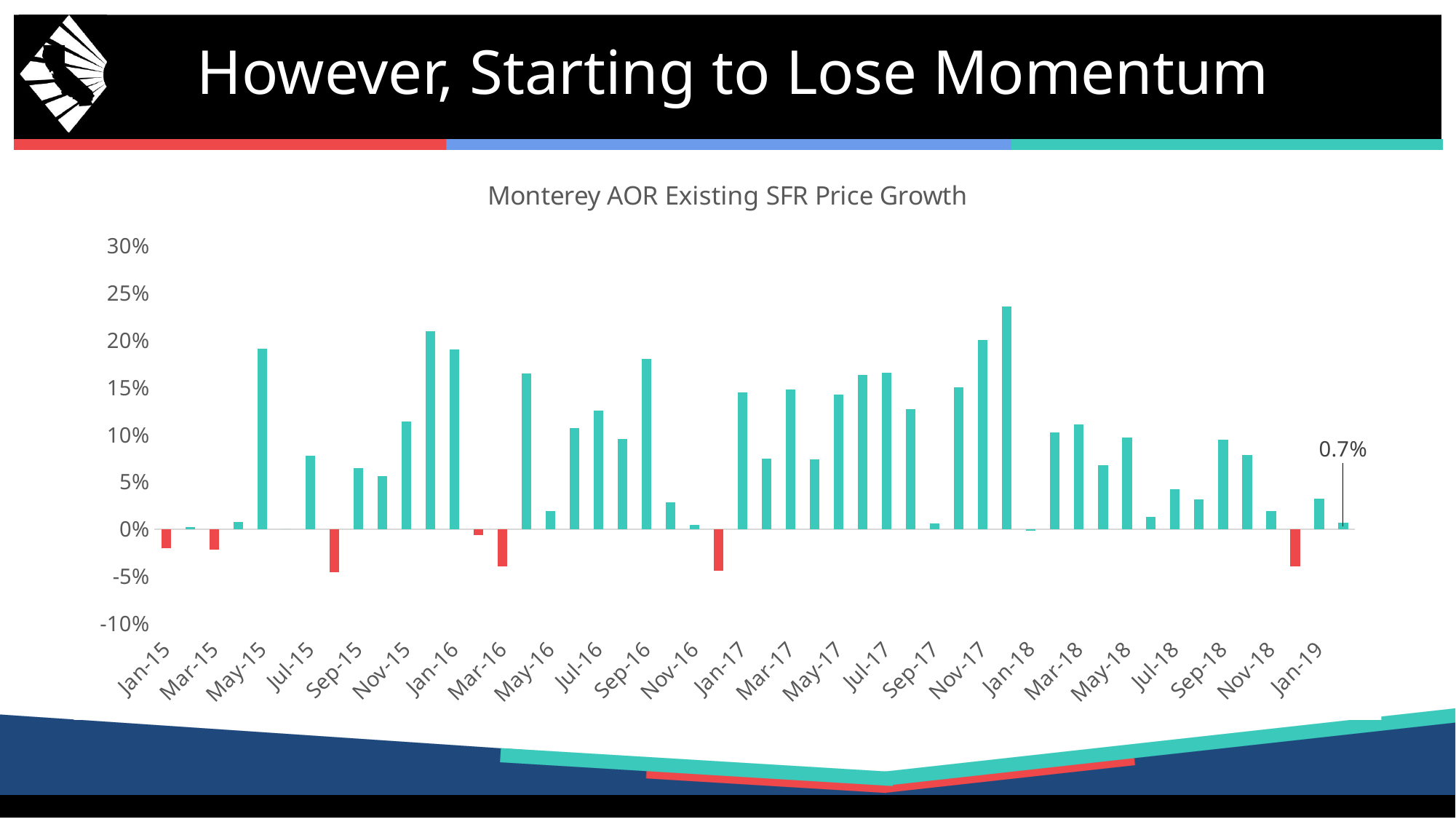
What value is shown by the data label on the last bar of the chart? 0.7% Do the values generally rise or fall from Nov-17 to Jan-19? fall What kind of chart is shown on the slide? bar chart What is the title of the chart? Monterey AOR Existing SFR Price Growth Which is larger, the value for Jan-16 or the value for Jan-19? Jan-16 Is the value for Jan-16 greater or less than 15%? greater What colour are the bars with negative values? red Is the value for Mar-16 greater or less than 0%? less Is the value for Nov-18 greater or less than 5%? less Which is larger, the value for May-15 or the value for May-18? May-15